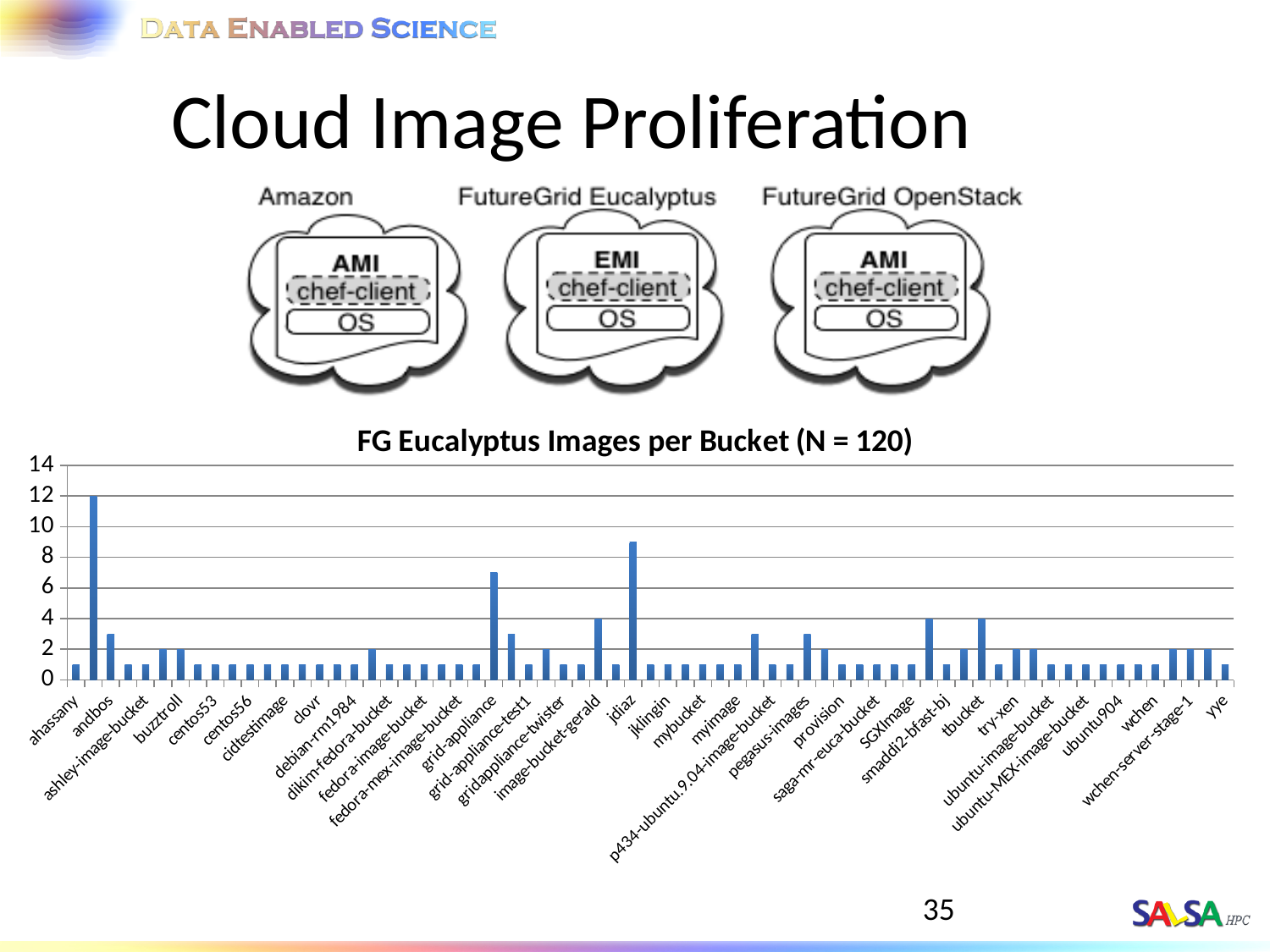
What kind of chart is shown on the slide? bar chart How many bars reach the value 12? 1 Is the value for yye greater or less than 2? less What is the value of the tallest bar in the chart? 12 What is the title of the chart? FG Eucalyptus Images per Bucket (N = 120) Is the value of the tallest bar greater or less than 10? greater What is the highest value shown on the vertical axis? 14 What is the total number of images (N) stated in the chart title? 120 Is the value for ahassany greater or less than 2? less